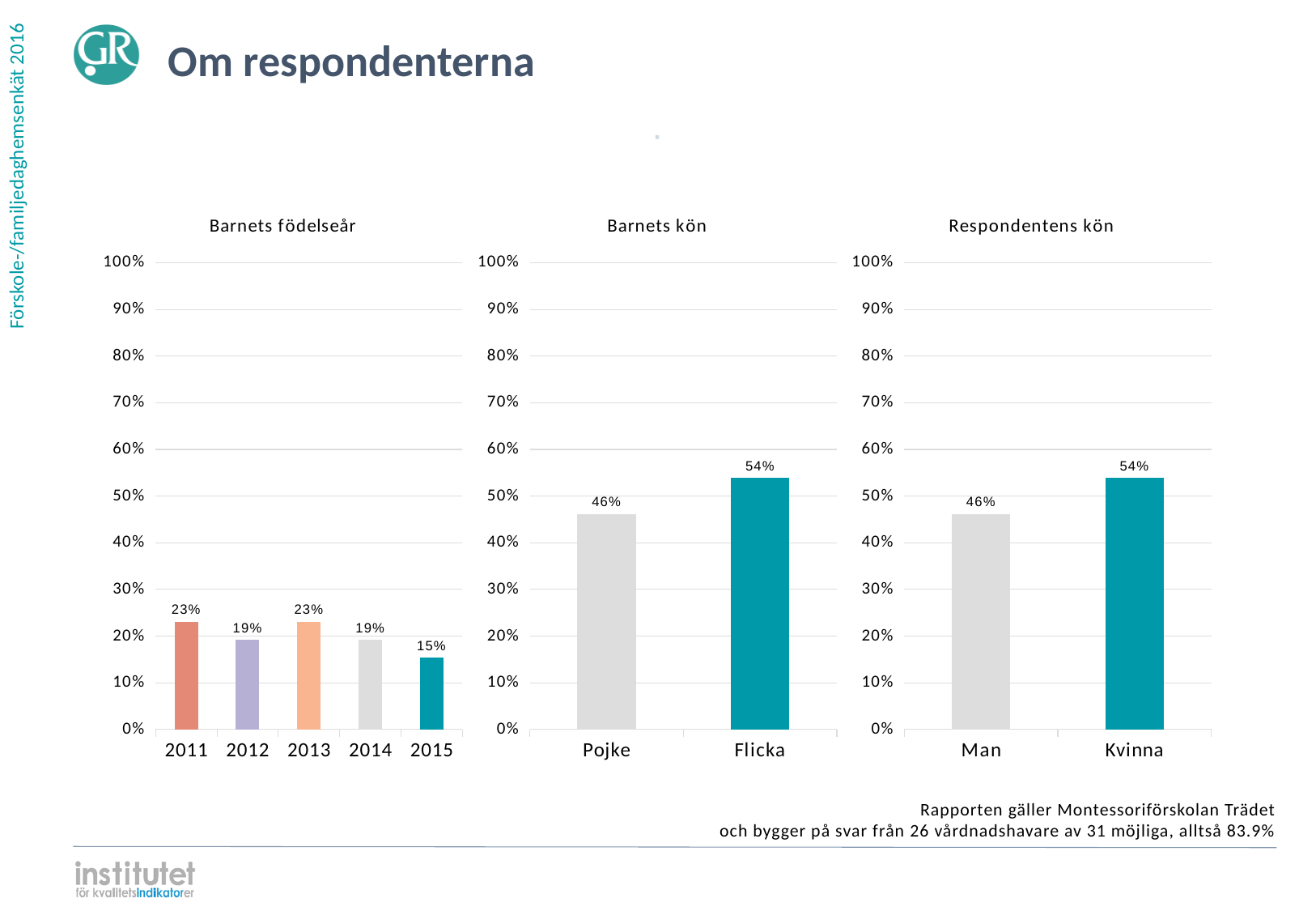
In the 'Barnets kön' chart, what is the value for Pojke? 46% In the 'Barnets kön' chart, which category has the higher value, Pojke or Flicka? Flicka In the 'Barnets kön' chart, what is the difference between Flicka and Pojke? 8% How many charts are shown on the slide? 3 In the 'Respondentens kön' chart, is the value for Man greater or less than 50%? less In the 'Barnets födelseår' chart, what is the value for 2012? 19% In the 'Barnets födelseår' chart, which year has the lowest value? 2015 In the 'Barnets födelseår' chart, what is the value for 2015? 15% In the 'Respondentens kön' chart, what is the value for Kvinna? 54% In the 'Barnets födelseår' chart, what is the difference between the values for 2011 and 2015? 8% In the 'Barnets födelseår' chart, how many years are shown on the x axis? 5 What kind of chart is the 'Respondentens kön' chart? Bar chart